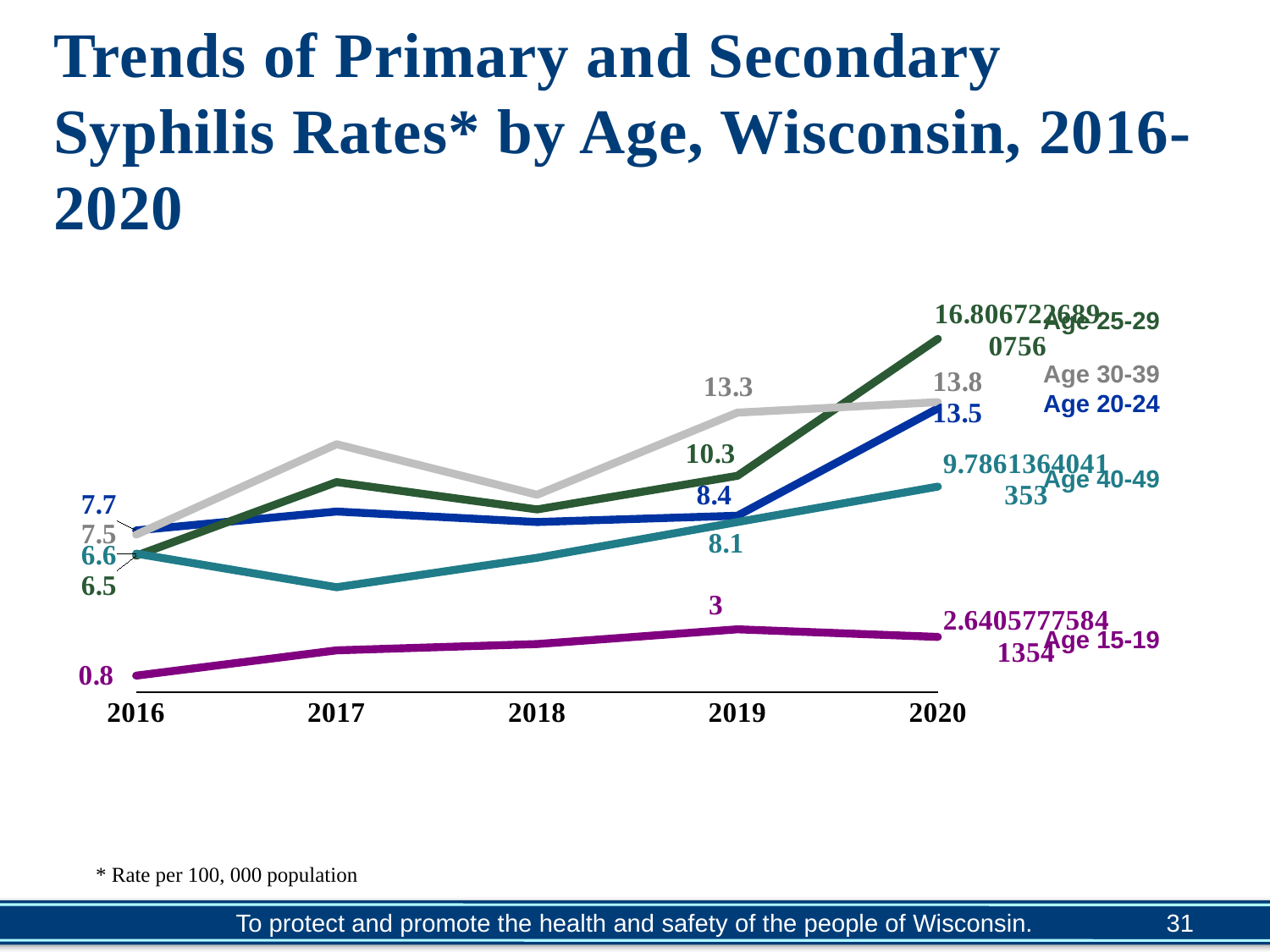
Which age group had the lowest rate in 2020? Age 15-19 Which age group had the highest rate in 2019? Age 30-39 Did the rate for Age 25-29 rise or fall from 2016 to 2020? rise In 2020, which had the higher rate: Age 30-39 or Age 20-24? Age 30-39 What was the syphilis rate for Age 40-49 in 2019? 8.1 How many years are shown along the x axis of the chart? 5 How many age groups (series) are plotted in the chart? 5 What is the difference between the 2019 rates for Age 30-39 and Age 20-24? 4.9 What was the syphilis rate for Age 15-19 in 2016? 0.8 What was the syphilis rate for Age 30-39 in 2019? 13.3 What type of chart is shown on the slide? line chart What was the syphilis rate for Age 25-29 in 2019? 10.3